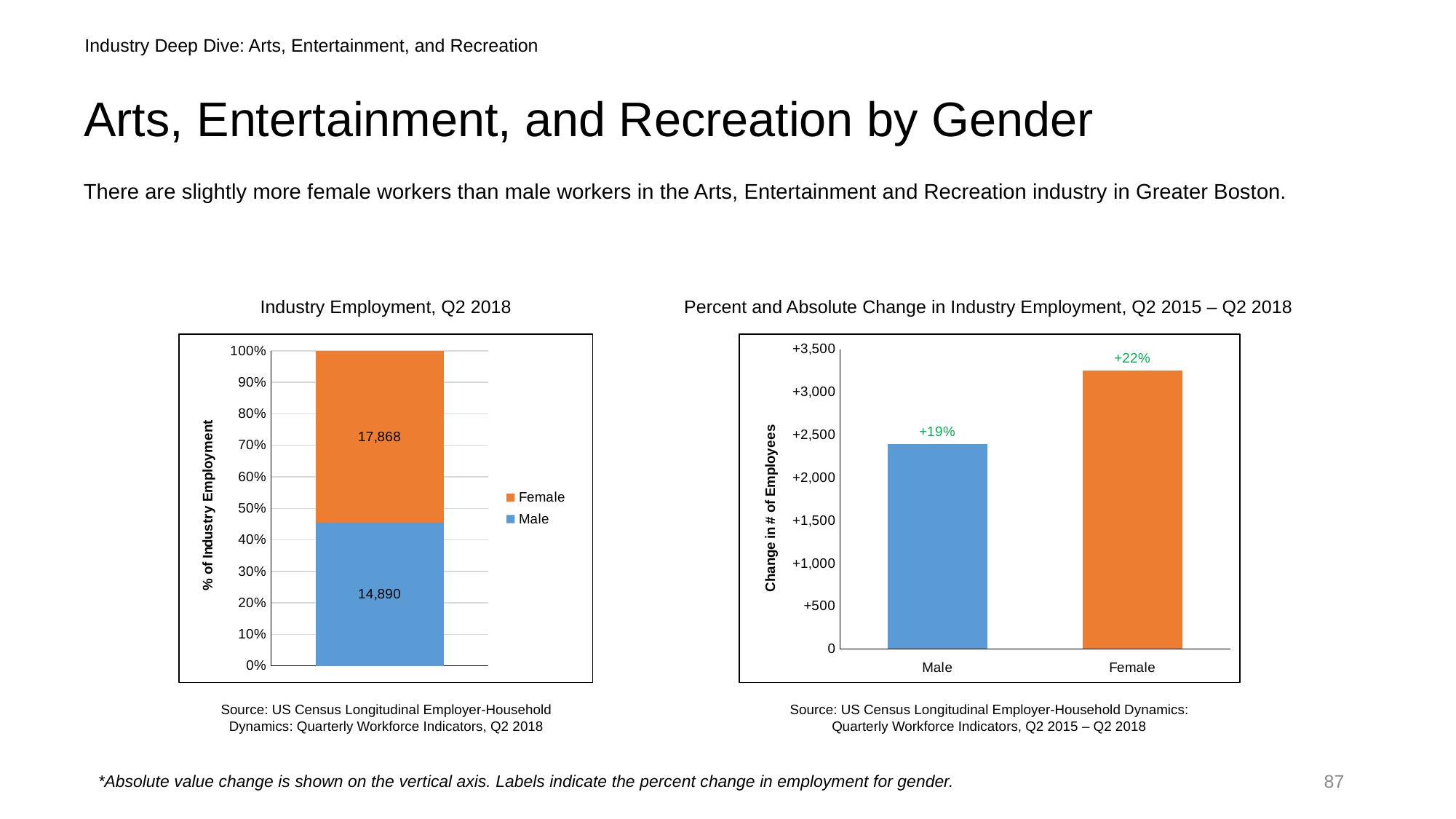
In the 'Percent and Absolute Change in Industry Employment, Q2 2015 – Q2 2018' chart, is the value for Female greater or less than +3,000? greater In the 'Percent and Absolute Change in Industry Employment, Q2 2015 – Q2 2018' chart, is the value for Male greater or less than +2,500? less In the 'Industry Employment, Q2 2018' chart, what is the total of the stacked bar? 32,758 In the 'Industry Employment, Q2 2018' chart, what is the difference between the Female and Male values? 2,978 In the 'Industry Employment, Q2 2018' chart, what colour represents Female? Orange In the 'Percent and Absolute Change in Industry Employment, Q2 2015 – Q2 2018' chart, what percent change label is shown for Male? +19% In the 'Percent and Absolute Change in Industry Employment, Q2 2015 – Q2 2018' chart, which category has the highest bar? Female In the 'Industry Employment, Q2 2018' chart, how many series does the legend list? 2 In the 'Industry Employment, Q2 2018' chart, what is the value shown for Male? 14,890 In the 'Industry Employment, Q2 2018' chart, what is the value shown for Female? 17,868 In the 'Percent and Absolute Change in Industry Employment, Q2 2015 – Q2 2018' chart, what percent change label is shown for Female? +22% In the 'Industry Employment, Q2 2018' chart, which is larger, the Female value or the Male value? Female